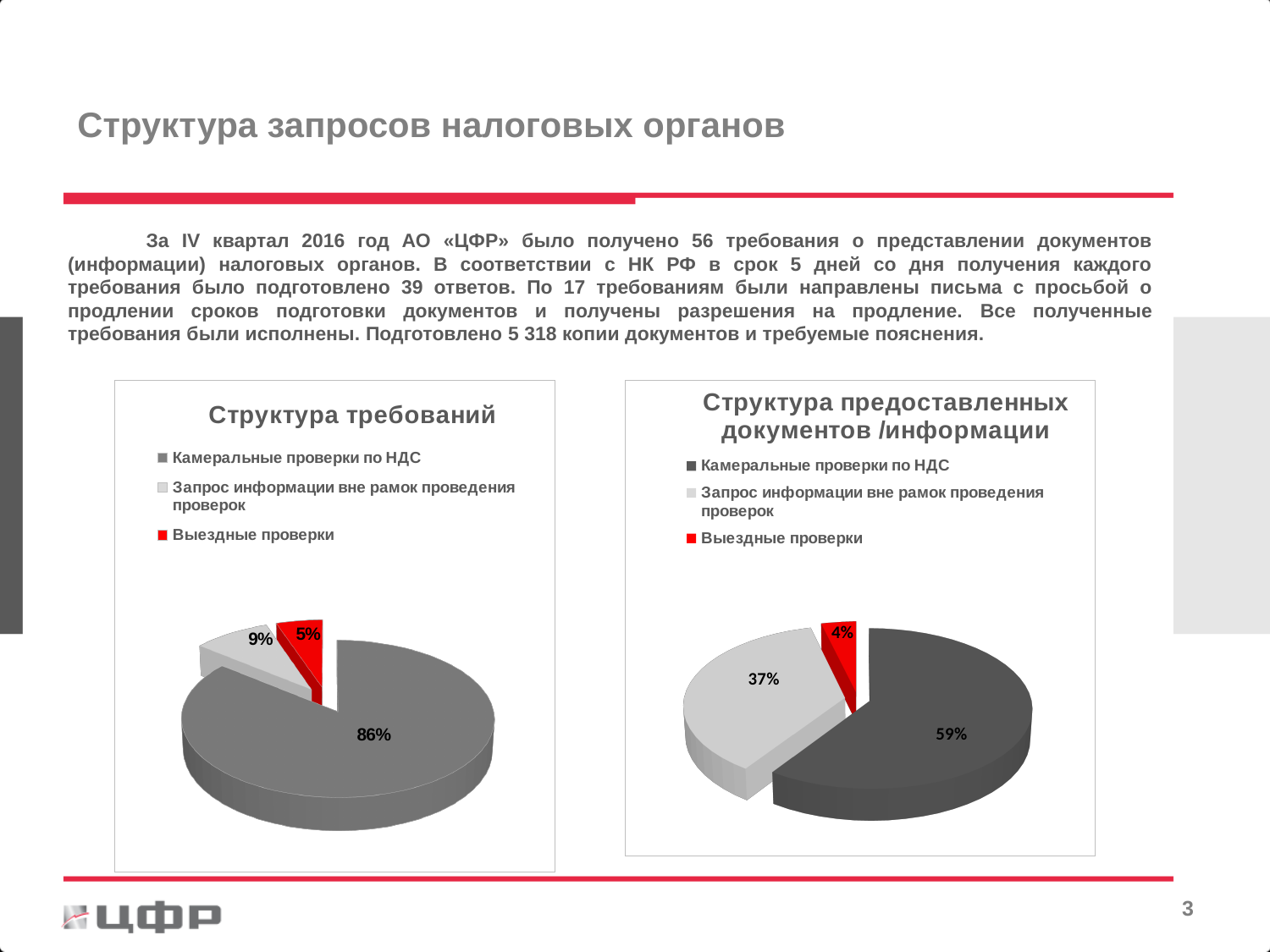
How many categories does the legend of the chart titled «Структура предоставленных документов /информации» list? 3 In the chart titled «Структура предоставленных документов /информации», which category has the smallest slice? Выездные проверки In the chart titled «Структура требований», what share does «Камеральные проверки по НДС» have? 86% In the chart titled «Структура требований», what share does «Выездные проверки» have? 5% In the chart titled «Структура требований», which category has the largest slice? Камеральные проверки по НДС In the chart titled «Структура предоставленных документов /информации», what is the difference between the shares of «Камеральные проверки по НДС» and «Запрос информации вне рамок проведения проверок»? 22% In the chart titled «Структура требований», what share does «Запрос информации вне рамок проведения проверок» have? 9% In the chart titled «Структура предоставленных документов /информации», what share does «Камеральные проверки по НДС» have? 59% What type of chart is the chart titled «Структура требований»? Pie chart In the chart titled «Структура предоставленных документов /информации», what share does «Выездные проверки» have? 4% In the chart titled «Структура предоставленных документов /информации», what share does «Запрос информации вне рамок проведения проверок» have? 37% In the chart titled «Структура требований», which is larger: the share of «Запрос информации вне рамок проведения проверок» or the share of «Выездные проверки»? Запрос информации вне рамок проведения проверок